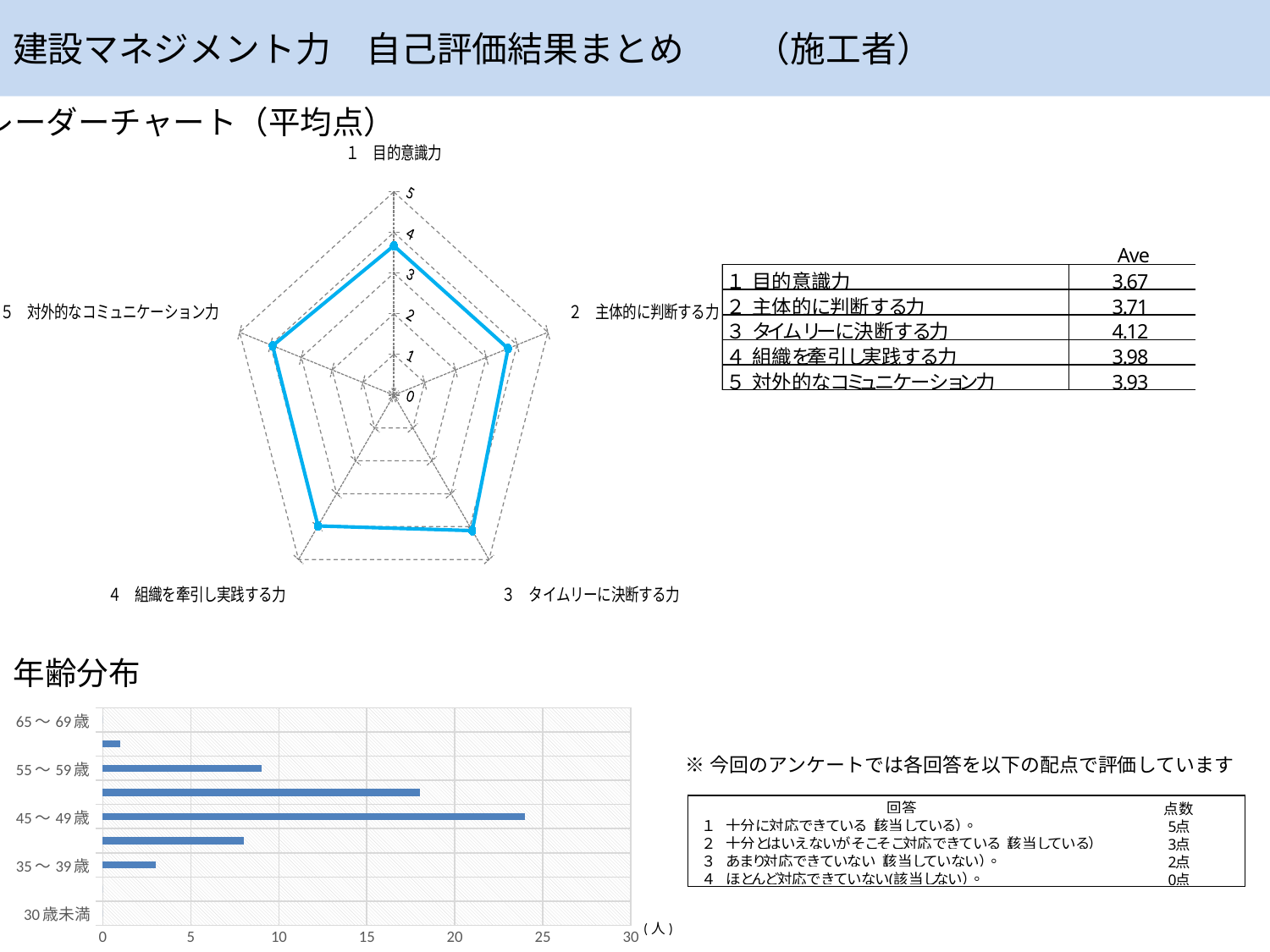
In the 年齢分布 chart, which labeled age group has the longest bar? 45〜49歳 In the 年齢分布 chart, is the value for 45〜49歳 greater or less than 20? greater In the radar chart (レーダーチャート（平均点）), how many axes (categories) are plotted? 5 In the radar chart (レーダーチャート（平均点）), what is the average score for 4 組織を牽引し実践する力 as shown in the table? 3.98 In the radar chart (レーダーチャート（平均点）), what is the average score for 5 対外的なコミュニケーション力 as shown in the table? 3.93 What kind of chart is the lower chart (年齢分布)? bar chart In the 年齢分布 chart, which is larger, the value for 55〜59歳 or the value for 35〜39歳? 55〜59歳 What kind of chart is the upper chart (レーダーチャート（平均点）)? radar chart In the 年齢分布 chart, is the value for 55〜59歳 greater or less than 10? less In the radar chart (レーダーチャート（平均点）), which category has the highest average score? 3 タイムリーに決断する力 In the radar chart (レーダーチャート（平均点）), which category has the lowest average score? 1 目的意識力 In the radar chart (レーダーチャート（平均点）), what is the maximum value shown on the radial axis? 5